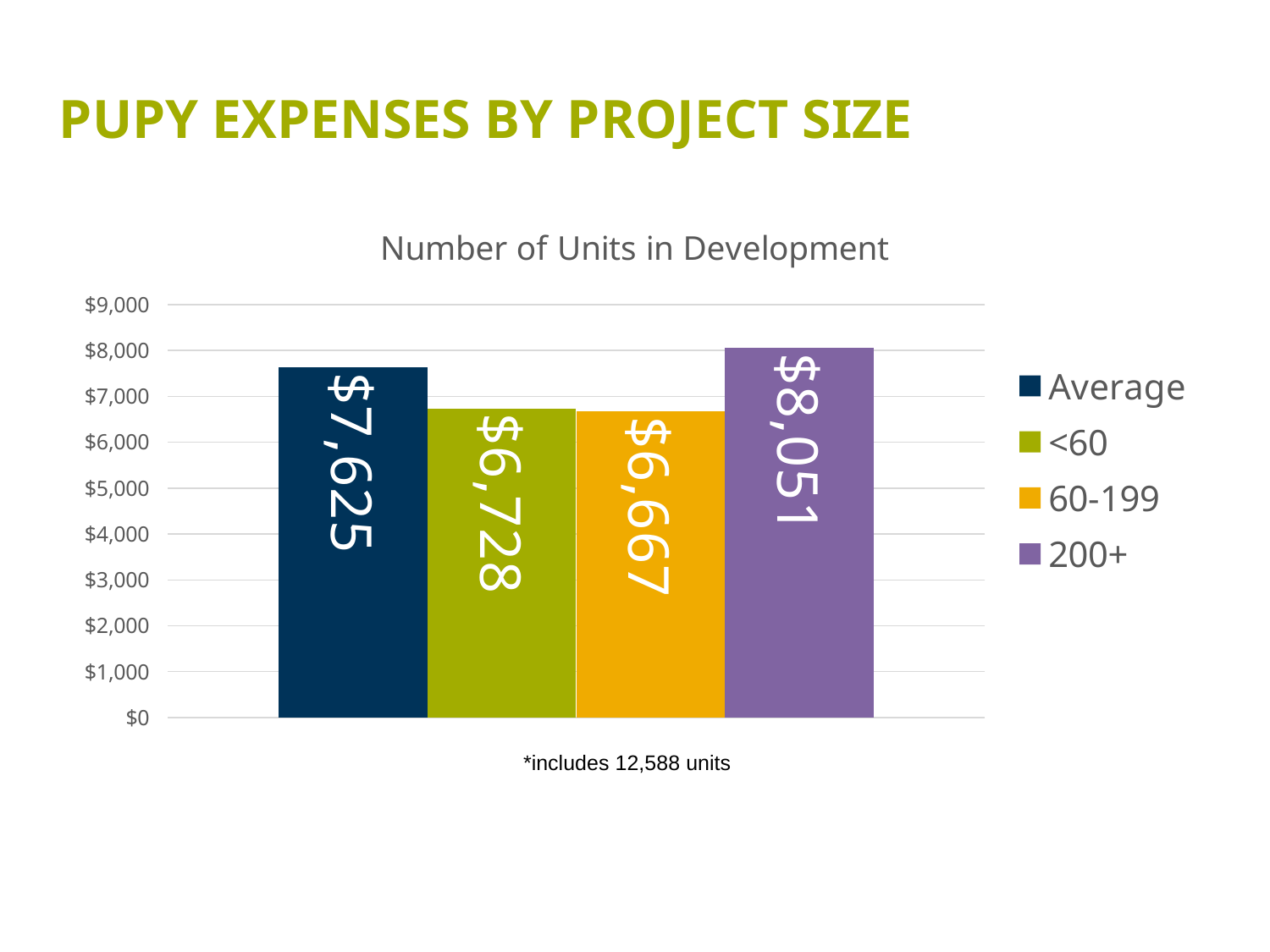
What is the PUPY expense value for the Average series? $7,625 How many series does the legend list? 4 What is the PUPY expense value for projects with <60 units? $6,728 Which series has the highest PUPY expense? 200+ What is the difference between the PUPY expense for 200+ units and the Average? $426 Which is larger, the PUPY expense for the Average or for <60 units? Average What is the PUPY expense value for projects with 200+ units? $8,051 What type of chart is shown on the slide? Bar chart What is the PUPY expense value for projects with 60-199 units? $6,667 Is the value for 200+ units greater or less than $8,000? greater Which series has the lowest PUPY expense? 60-199 What is the difference between the PUPY expense for <60 units and 60-199 units? $61